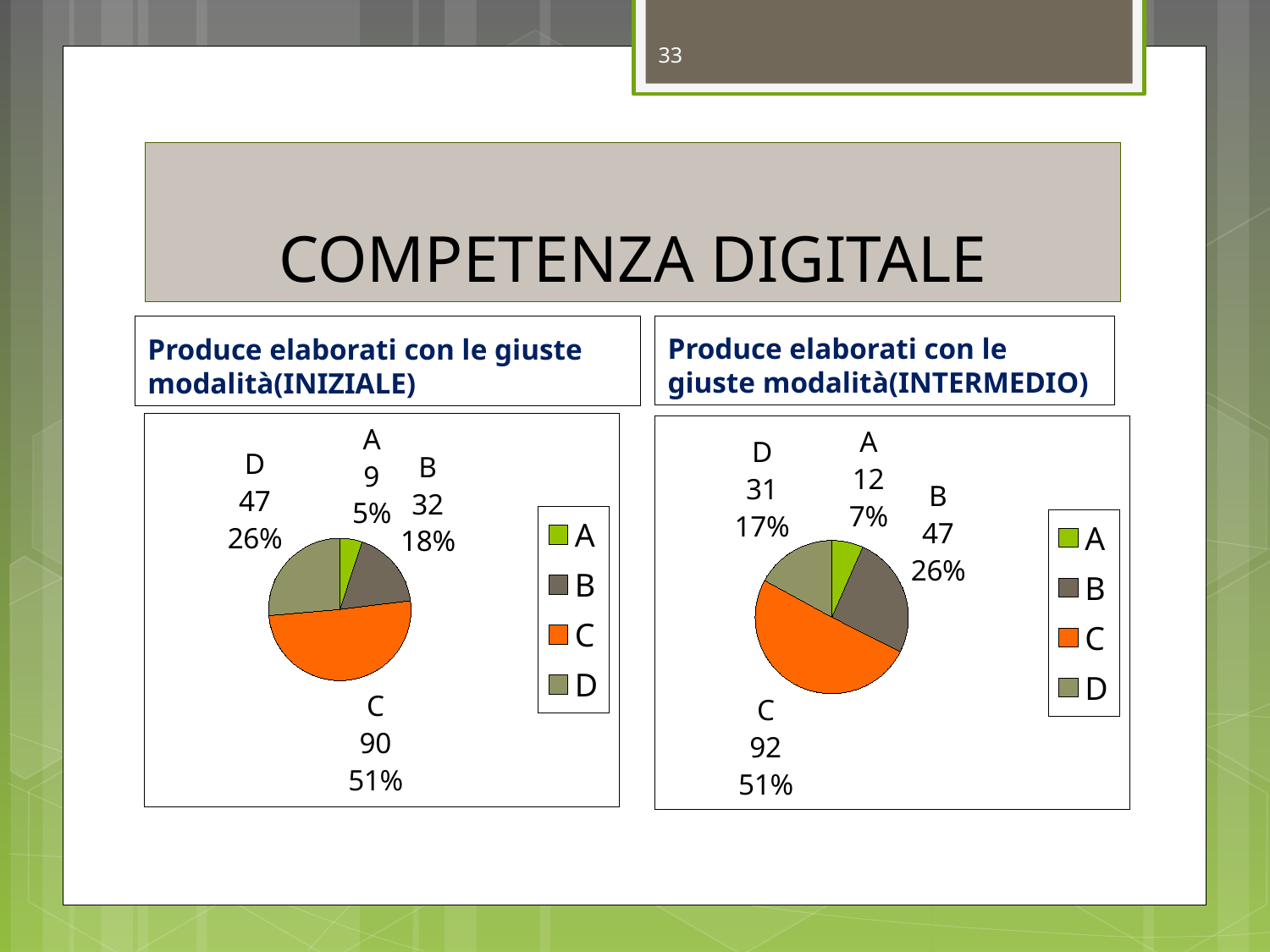
In the INTERMEDIO pie chart (right), which category has the smallest slice? A In the INIZIALE pie chart (left), what colour is the slice for category C? Orange In the INTERMEDIO pie chart (right), what is the value for category B? 47 In the INIZIALE pie chart (left), what is the value for category C? 90 In the INIZIALE pie chart (left), which category has the largest slice? C What type of chart is used on the right side of the slide (INTERMEDIO)? Pie chart In the INIZIALE pie chart (left), what is the difference between the values for D and B? 15 In the INTERMEDIO pie chart (right), what percentage share does category A have? 7% How many categories does the INIZIALE pie chart (left) show? 4 In the INIZIALE pie chart (left), what percentage share does category D have? 26% In the INTERMEDIO pie chart (right), what is the difference between the values for C and D? 61 In the INTERMEDIO pie chart (right), which is larger, the value for B or the value for D? B